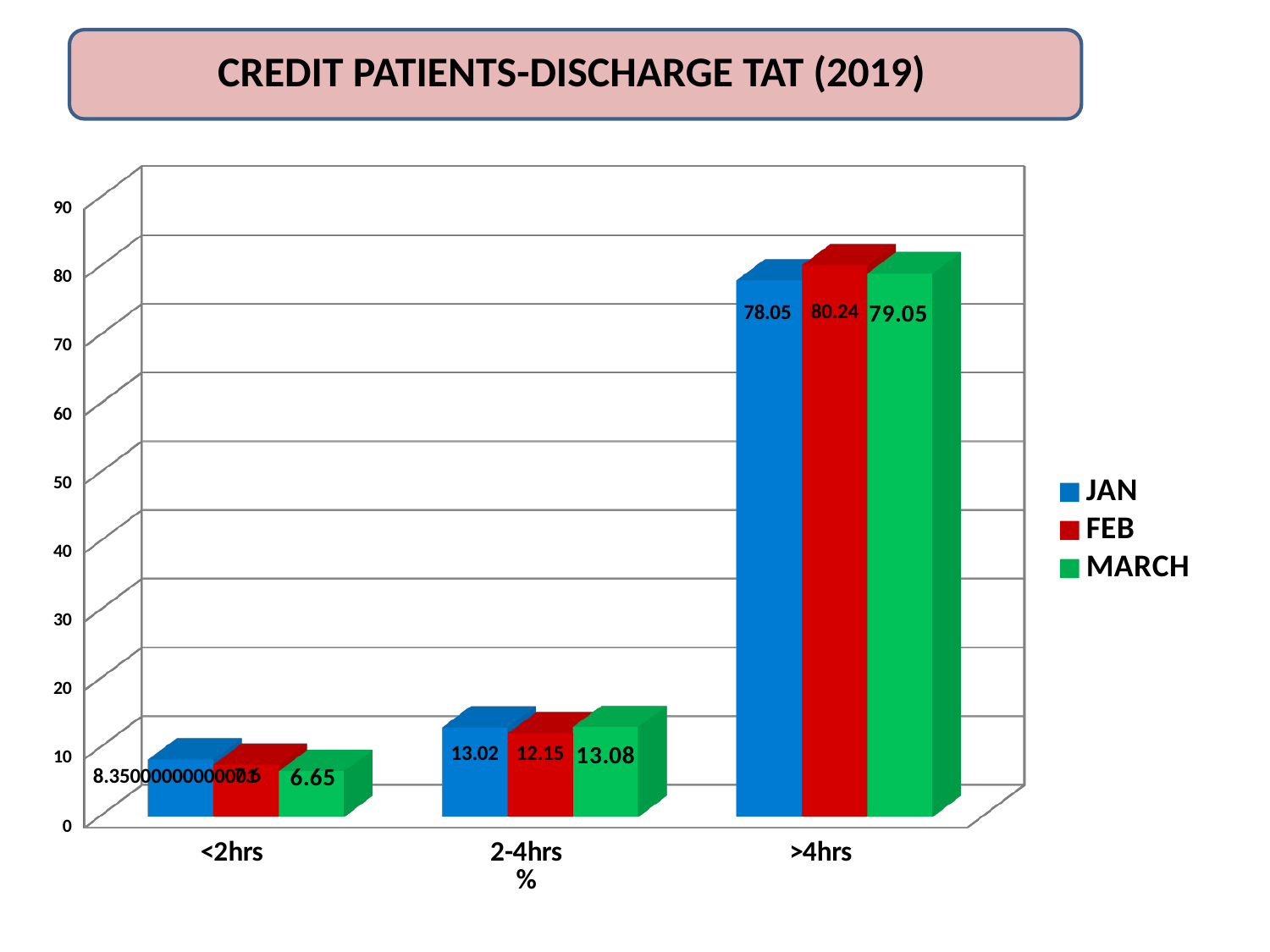
In the >4hrs category, how much higher is the FEB value than the JAN value? 2.19 In the >4hrs category, which is larger: the FEB value or the MARCH value? FEB Which month has the highest value in the >4hrs category? FEB What is the MARCH value for the 2-4hrs category? 13.08 What is the JAN value for the >4hrs category? 78.05 How many categories are shown on the x axis? 3 How many series does the legend list? 3 Which month has the lowest value in the 2-4hrs category? FEB What is the FEB value for the >4hrs category? 80.24 Is the JAN value for >4hrs greater or less than 70? greater What is the MARCH value for the <2hrs category? 6.65 In the 2-4hrs category, what is the difference between the MARCH value and the FEB value? 0.93